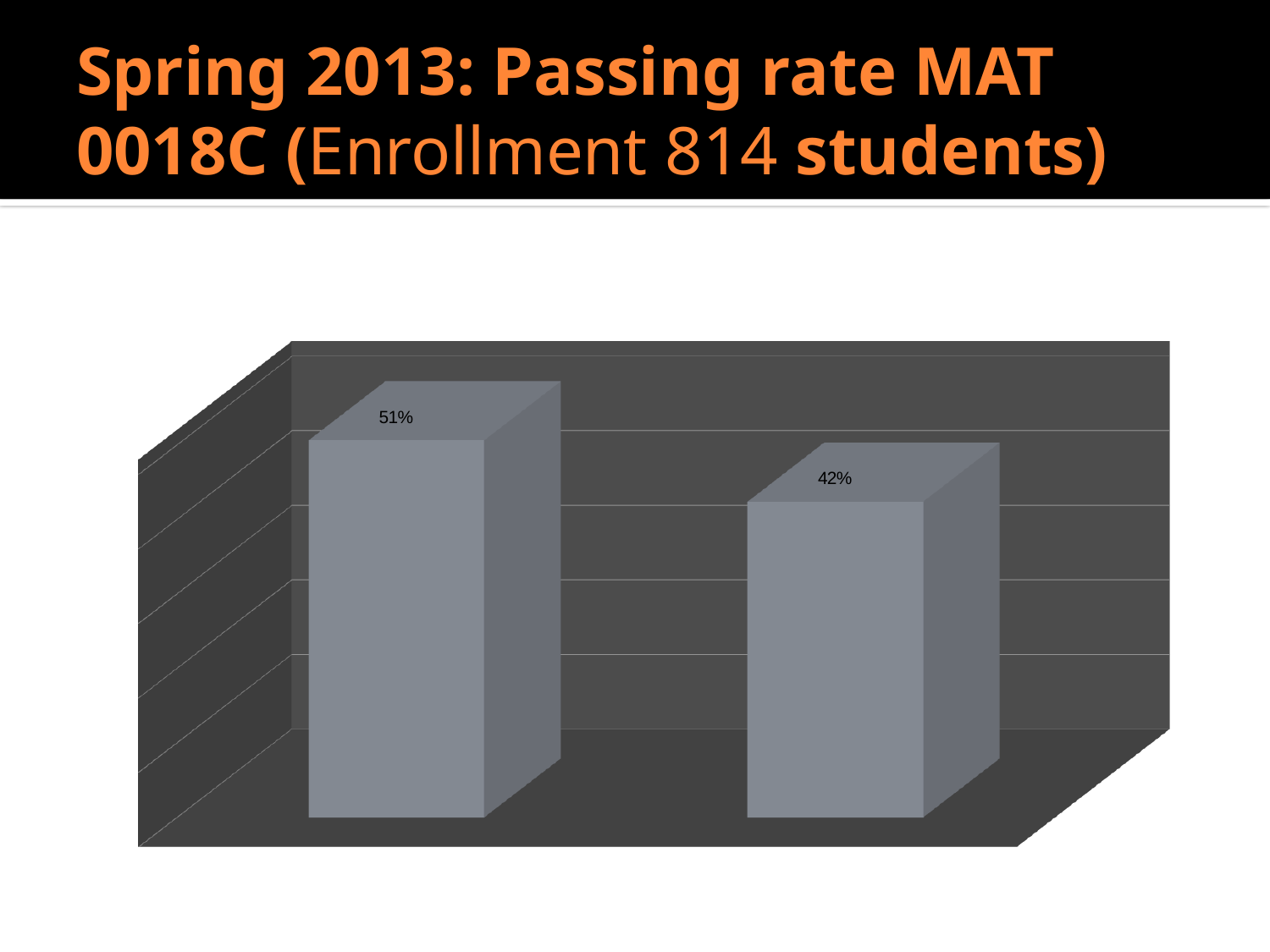
What value is shown on the right bar of the chart? 42% How many bars are plotted in the chart? 2 Do the bar values rise or fall from left to right? fall Is the value of the left bar larger or smaller than the value of the right bar? larger What kind of chart is shown on the slide? bar chart Which bar has the lower value, the left bar or the right bar? the right bar What value is shown on the left bar of the chart? 51% Which bar has the higher value, the left bar or the right bar? the left bar Which course does the slide title say the passing rate chart is for? MAT 0018C What is the difference between the left bar's value and the right bar's value? 9% According to the slide title, how many students were enrolled in MAT 0018C in Spring 2013? 814